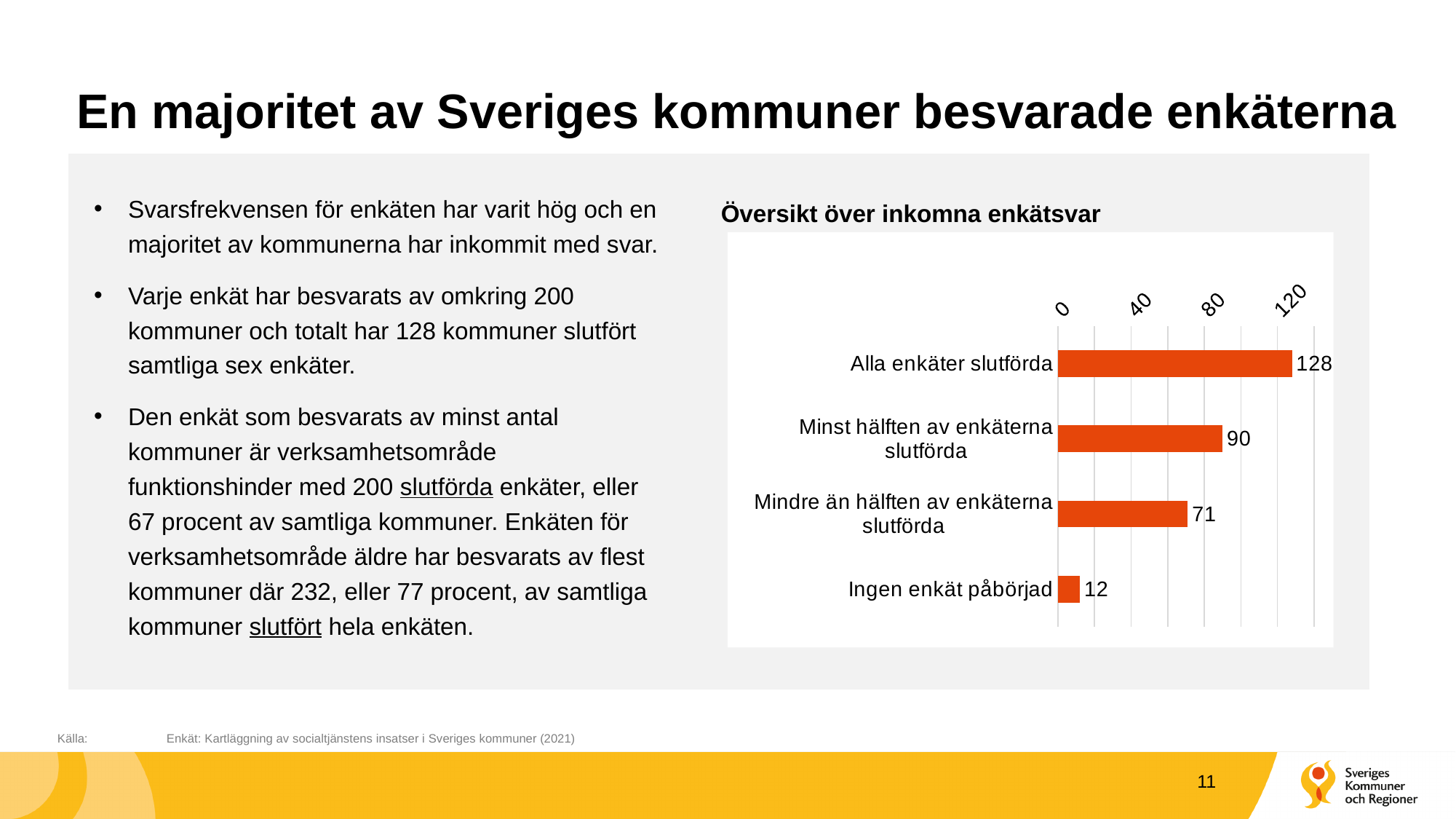
What is the difference between the values for "Alla enkäter slutförda" and "Minst hälften av enkäterna slutförda"? 38 What is the title of the chart? Översikt över inkomna enkätsvar Which is larger: the value for "Minst hälften av enkäterna slutförda" or "Mindre än hälften av enkäterna slutförda"? Minst hälften av enkäterna slutförda What is the difference between the values for "Mindre än hälften av enkäterna slutförda" and "Ingen enkät påbörjad"? 59 What is the value for "Minst hälften av enkäterna slutförda"? 90 Which category has the lowest value? Ingen enkät påbörjad What is the value for "Alla enkäter slutförda"? 128 What is the value for "Mindre än hälften av enkäterna slutförda"? 71 What is the value for "Ingen enkät påbörjad"? 12 Which category has the highest value? Alla enkäter slutförda What kind of chart is shown on the slide? Bar chart How many categories are shown in the chart? 4